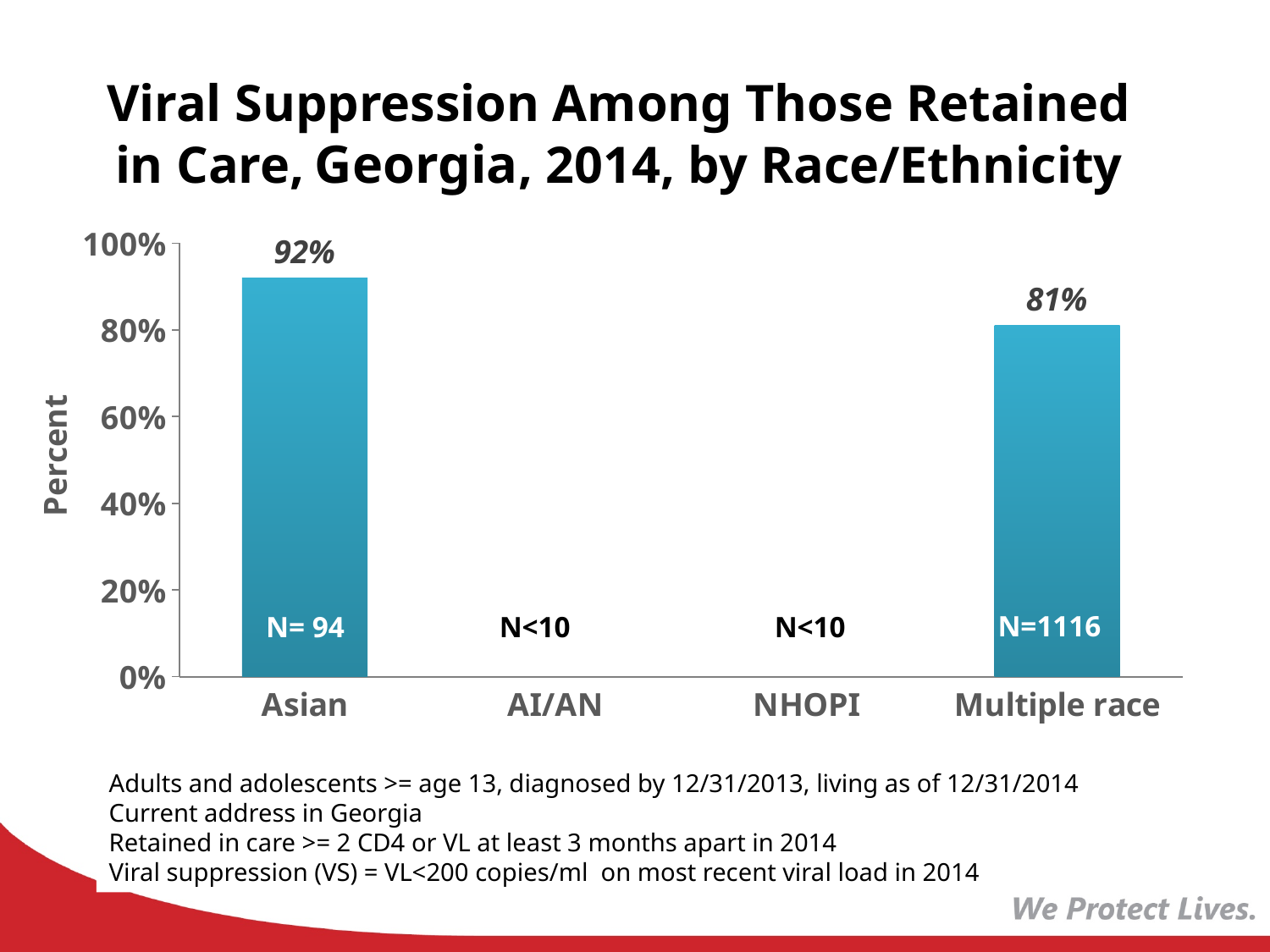
Which race/ethnicity category has the highest viral suppression percentage shown? Asian What is the viral suppression percentage for Multiple race? 81% How many race/ethnicity categories are listed on the x axis? 4 Which has a higher viral suppression percentage, Asian or Multiple race? Asian What is the difference in viral suppression percentage between Asian and Multiple race? 11% What label is shown for the AI/AN and NHOPI categories instead of a bar? N<10 What is the N shown for the Multiple race category? N=1116 What is the N shown for the Asian category? N= 94 What is the viral suppression percentage for Asian? 92% What is the label on the y axis? Percent What kind of chart is shown on the slide? Bar chart Is the value for Multiple race greater or less than 60%? greater